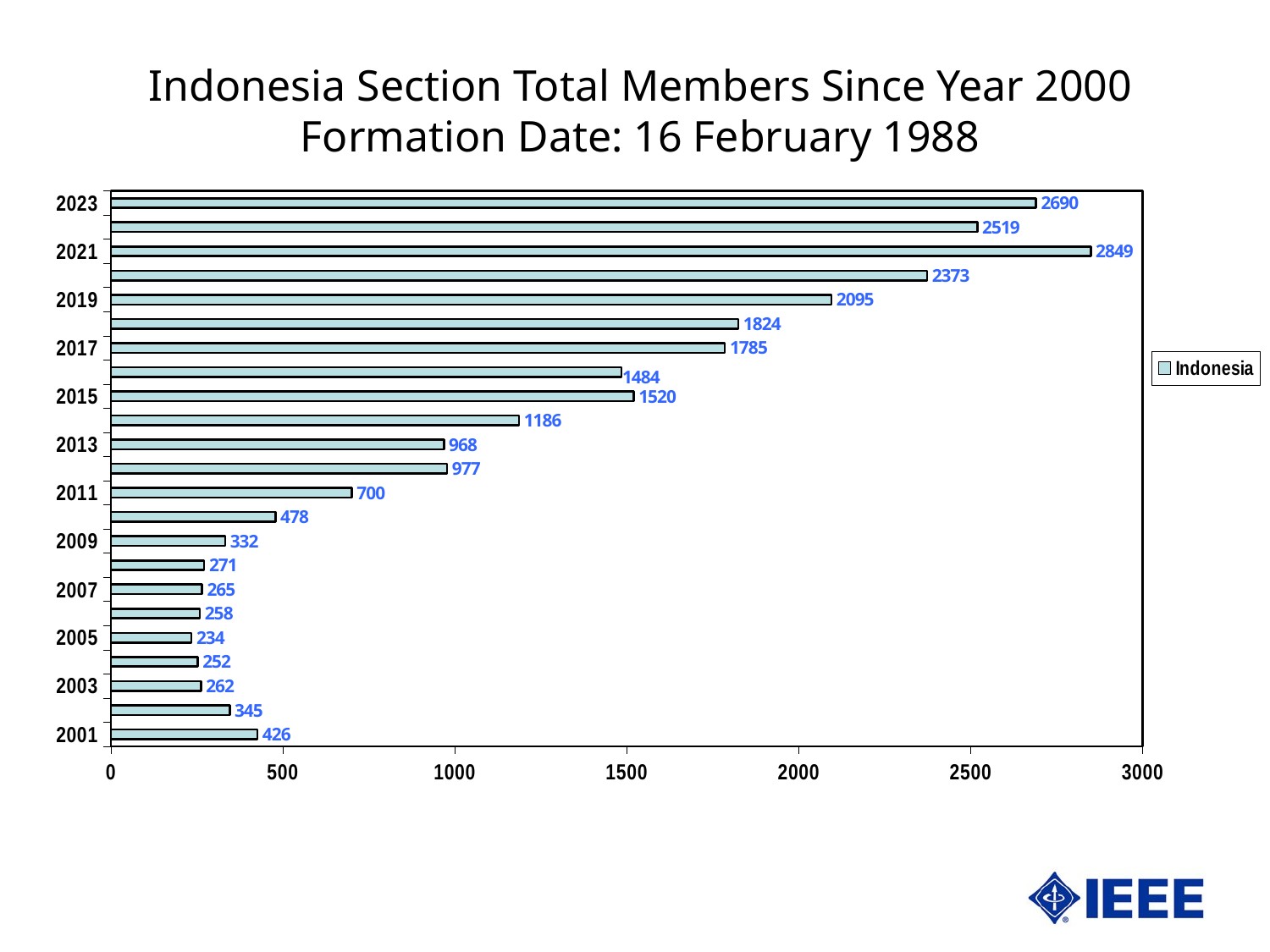
What is the difference between the values for 2021 and 2023? 159 What is the value for 2001? 426 What kind of chart is shown? bar chart Which year has the lowest value? 2005 What is the value for 2021? 2849 What is the value for 2023? 2690 What series name does the legend show? Indonesia Which year has the highest value? 2021 Which is larger, the value for 2015 or the value for 2017? 2017 Is the value for 2019 greater or less than 2000? greater How many bars are plotted in the chart? 23 What is the value for 2013? 968